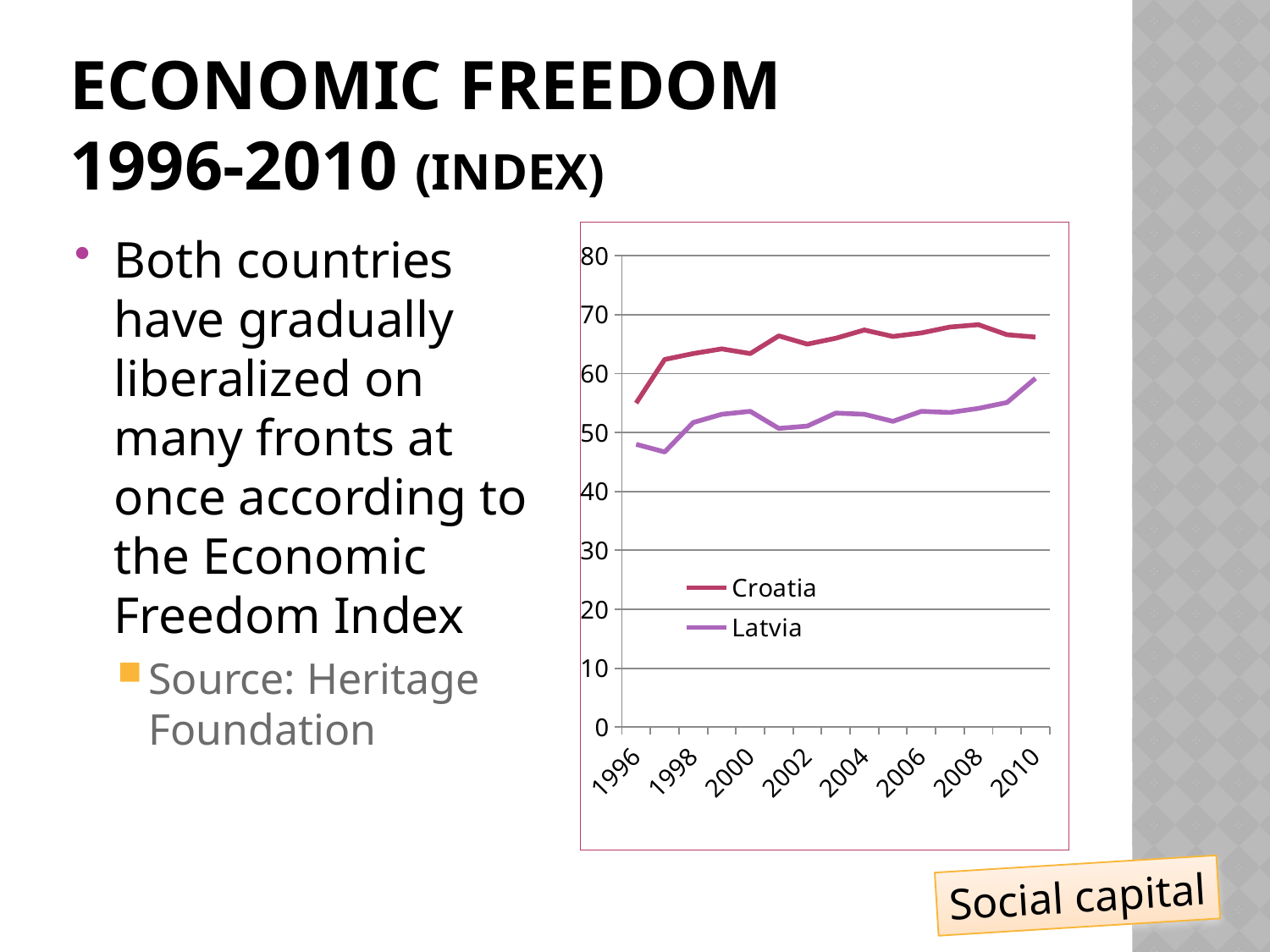
Is the value for Croatia in 1996 greater or less than 50? greater What kind of chart is shown on the slide? line chart Overall, does the Latvia line rise or fall from 1996 to 2010? rise Is the value for Croatia in 2010 greater or less than 60? greater Is the value for Latvia in 2010 greater or less than 50? greater How many series does the chart's legend list? 2 Which series reaches the highest value on the chart? Croatia Which country has the higher value in 2004, Croatia or Latvia? Croatia Which series is drawn in purple? Latvia Which two countries are shown in the chart's legend? Croatia and Latvia